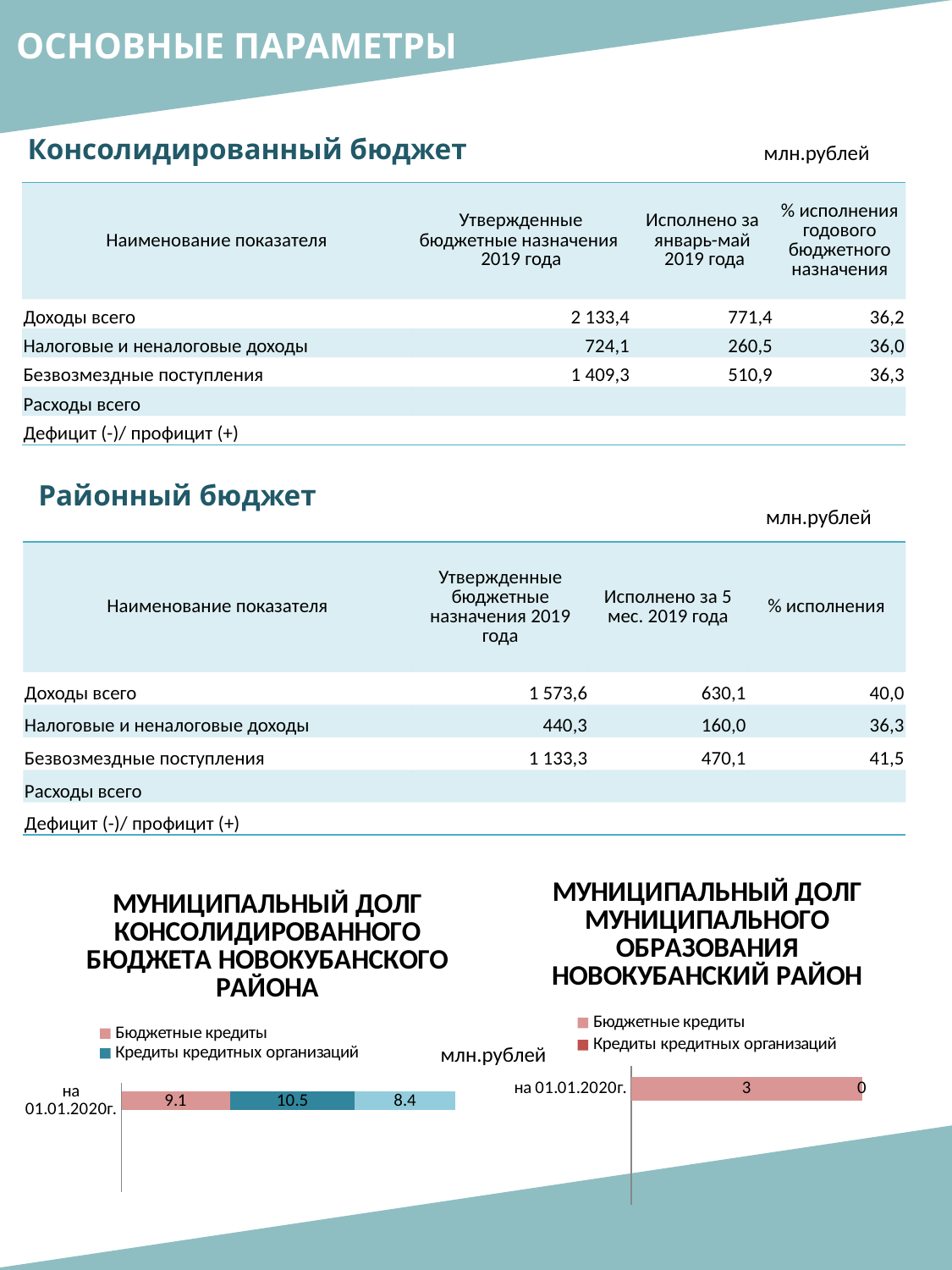
What kind of chart is the one titled 'МУНИЦИПАЛЬНЫЙ ДОЛГ КОНСОЛИДИРОВАННОГО БЮДЖЕТА НОВОКУБАНСКОГО РАЙОНА'? Stacked bar chart In the chart titled 'МУНИЦИПАЛЬНЫЙ ДОЛГ КОНСОЛИДИРОВАННОГО БЮДЖЕТА НОВОКУБАНСКОГО РАЙОНА', what is the difference between 'Кредиты кредитных организаций' and 'Бюджетные кредиты'? 1.4 How many categories are shown on the axis of the chart titled 'МУНИЦИПАЛЬНЫЙ ДОЛГ МУНИЦИПАЛЬНОГО ОБРАЗОВАНИЯ НОВОКУБАНСКИЙ РАЙОН'? 1 In the chart titled 'МУНИЦИПАЛЬНЫЙ ДОЛГ КОНСОЛИДИРОВАННОГО БЮДЖЕТА НОВОКУБАНСКОГО РАЙОНА', what is the total of the stacked bar for 01.01.2020? 28 In the chart titled 'МУНИЦИПАЛЬНЫЙ ДОЛГ КОНСОЛИДИРОВАННОГО БЮДЖЕТА НОВОКУБАНСКОГО РАЙОНА', which is larger: 'Бюджетные кредиты' or 'Кредиты кредитных организаций'? Кредиты кредитных организаций In the chart titled 'МУНИЦИПАЛЬНЫЙ ДОЛГ КОНСОЛИДИРОВАННОГО БЮДЖЕТА НОВОКУБАНСКОГО РАЙОНА', what is the value for 'Кредиты кредитных организаций'? 10.5 In the chart titled 'МУНИЦИПАЛЬНЫЙ ДОЛГ МУНИЦИПАЛЬНОГО ОБРАЗОВАНИЯ НОВОКУБАНСКИЙ РАЙОН', which series has the highest value? Бюджетные кредиты In the chart titled 'МУНИЦИПАЛЬНЫЙ ДОЛГ МУНИЦИПАЛЬНОГО ОБРАЗОВАНИЯ НОВОКУБАНСКИЙ РАЙОН', what is the value for 'Бюджетные кредиты' on 01.01.2020? 3 What unit is stated next to the charts at the bottom of the slide? млн.рублей How many series does the legend list in the chart titled 'МУНИЦИПАЛЬНЫЙ ДОЛГ КОНСОЛИДИРОВАННОГО БЮДЖЕТА НОВОКУБАНСКОГО РАЙОНА'? 2 In the chart titled 'МУНИЦИПАЛЬНЫЙ ДОЛГ МУНИЦИПАЛЬНОГО ОБРАЗОВАНИЯ НОВОКУБАНСКИЙ РАЙОН', what is the value for 'Кредиты кредитных организаций'? 0 In the chart titled 'МУНИЦИПАЛЬНЫЙ ДОЛГ КОНСОЛИДИРОВАННОГО БЮДЖЕТА НОВОКУБАНСКОГО РАЙОНА', what is the value for 'Бюджетные кредиты' on 01.01.2020? 9.1